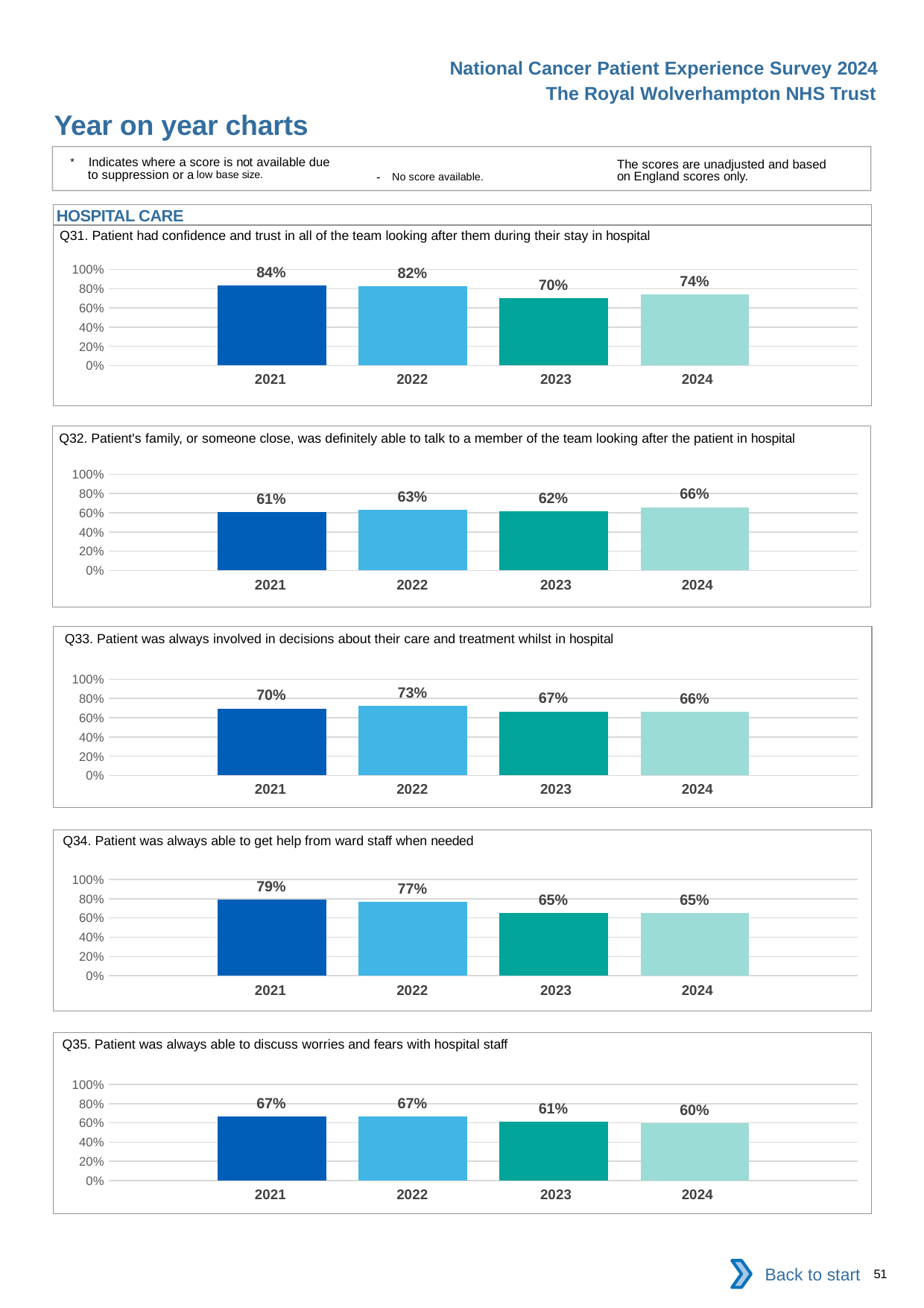
In the Q33 chart, what is the difference between the 2022 and 2024 values? 7% What type of chart is used for Q34? bar chart How many years are shown in the Q31 chart? 4 In the Q35 chart, do the values generally rise or fall from 2021 to 2024? fall In the Q34 chart, is the value for 2021 larger or smaller than the value for 2022? larger In the Q33 chart, which year has the highest value? 2022 In the Q31 chart, which year has the lowest value? 2023 In the Q35 chart, what is the value for 2024? 60% In the Q32 chart, what is the value for 2024? 66% In the Q31 chart, what is the value for 2021? 84% In the Q32 chart, which year has the highest value? 2024 In the Q34 chart, what is the value for 2023? 65%